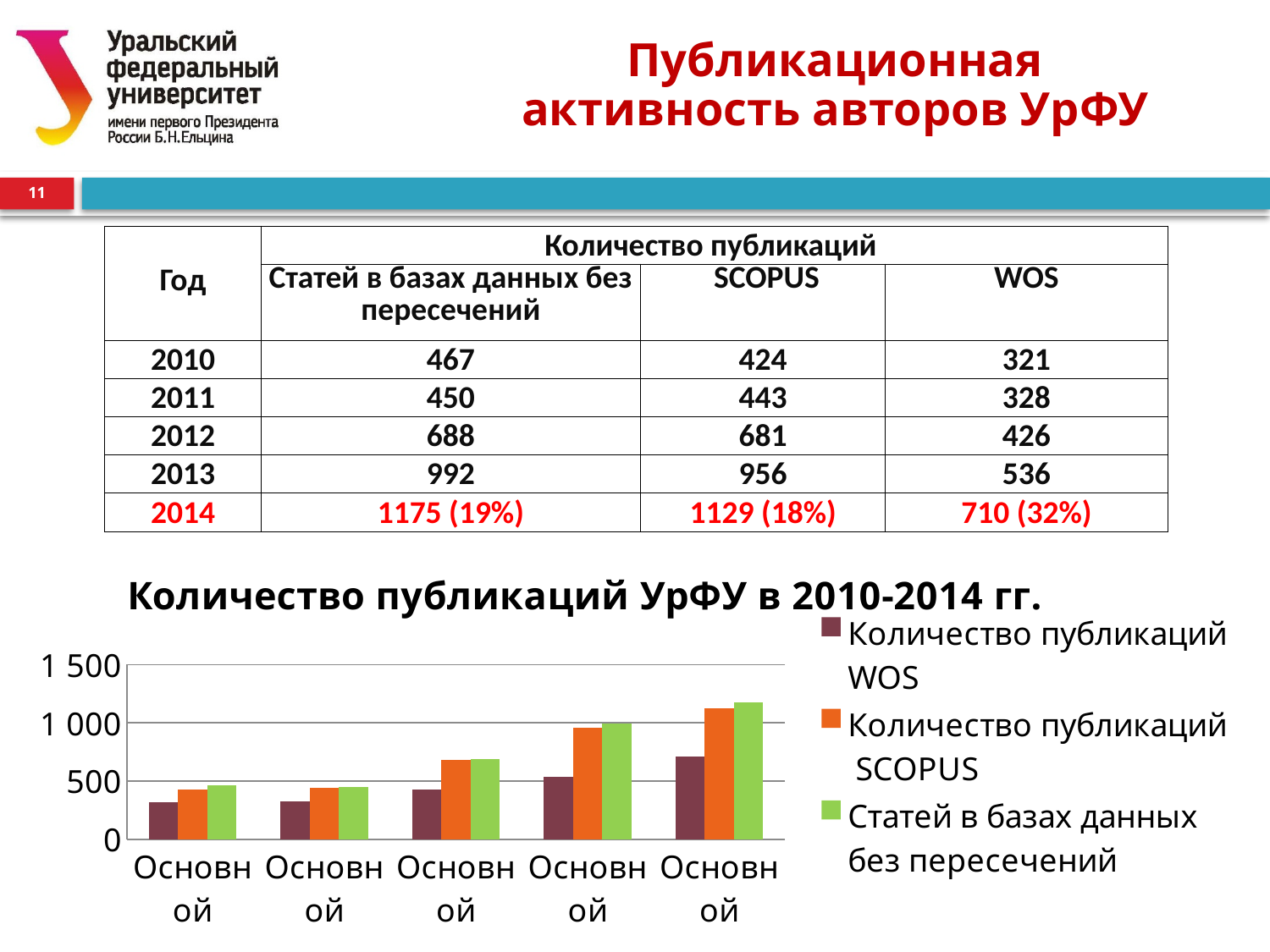
Which series has the lowest bar in every group of the chart? Количество публикаций WOS Do the bars for each series generally rise or fall from left to right along the x axis? rise In the rightmost group of bars, is the value for 'Количество публикаций WOS' greater or less than 500? greater Which legend entry is shown in dark red (maroon)? Количество публикаций WOS What is the title of the chart? Количество публикаций УрФУ в 2010-2014 гг. In the leftmost group of bars, is the value for 'Количество публикаций WOS' greater or less than 500? less In the rightmost group of bars, which is larger: 'Количество публикаций WOS' or 'Количество публикаций SCOPUS'? Количество публикаций SCOPUS How many series does the chart legend list? 3 What kind of chart is shown on the slide? bar chart In the middle (third) group of bars, is the value for 'Количество публикаций SCOPUS' greater or less than 500? greater How many groups of bars are plotted along the x axis of the chart? 5